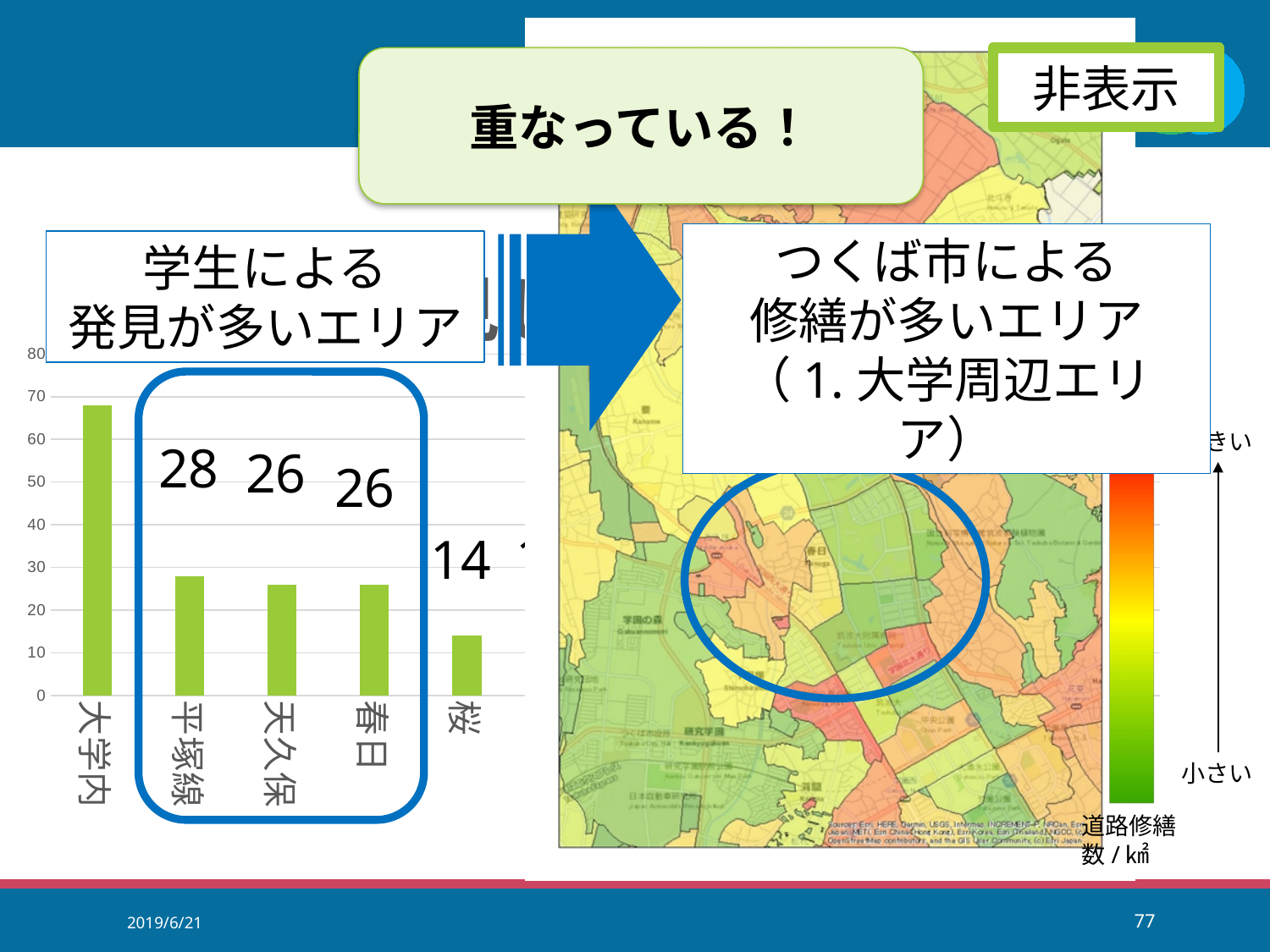
What is the difference between the values for 平塚線 and 桜 in the bar chart? 14 What kind of chart is shown on the left of the slide? bar chart What is the value for 春日 in the bar chart? 26 What is the value for 桜 in the bar chart? 14 In the bar chart, which is larger, the value for 平塚線 or the value for 桜? 平塚線 What is the value for 平塚線 in the bar chart? 28 Is the value for 大学内 in the bar chart greater or less than 60? greater What is the value for 天久保 in the bar chart? 26 In the bar chart, which is larger, the value for 大学内 or the value for 平塚線? 大学内 What is the difference between the values for 平塚線 and 天久保 in the bar chart? 2 Do the values in the bar chart rise or fall from left to right along the x axis? fall Is the value for 桜 in the bar chart greater or less than 20? less